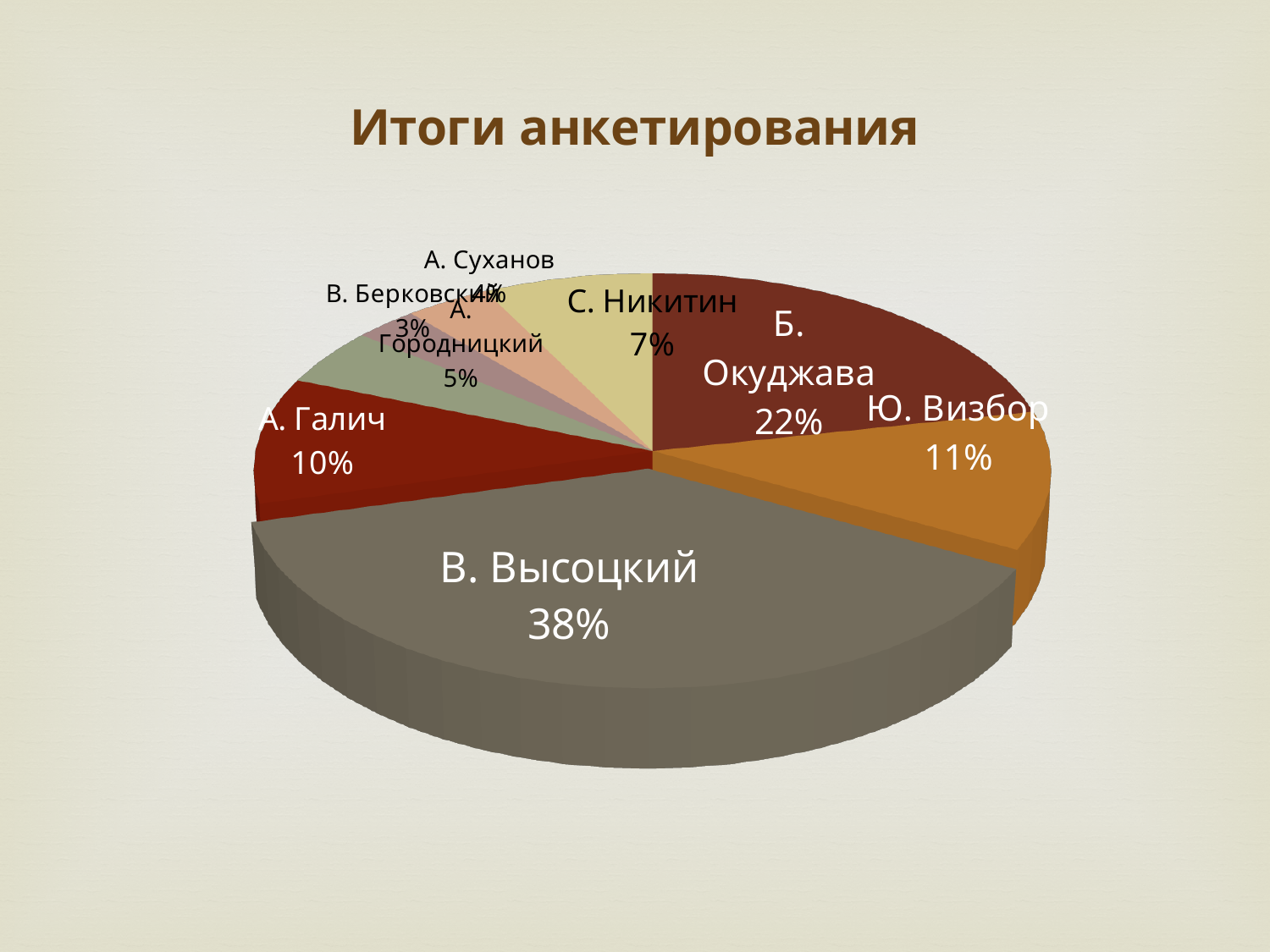
What share of the pie does А. Городницкий have? 5% What share of the pie does Б. Окуджава have? 22% What share of the pie does С. Никитин have? 7% Which is larger, the share of Ю. Визбор or the share of А. Галич? Ю. Визбор Which slice of the pie is the largest? В. Высоцкий What share of the pie does Ю. Визбор have? 11% What is the difference between the shares of В. Высоцкий and Б. Окуджава? 16% What share of the pie does А. Галич have? 10% Which slice of the pie is the smallest? В. Берковский What share of the pie does В. Высоцкий have? 38% What kind of chart is shown on the slide? pie chart What is the title of the chart? Итоги анкетирования